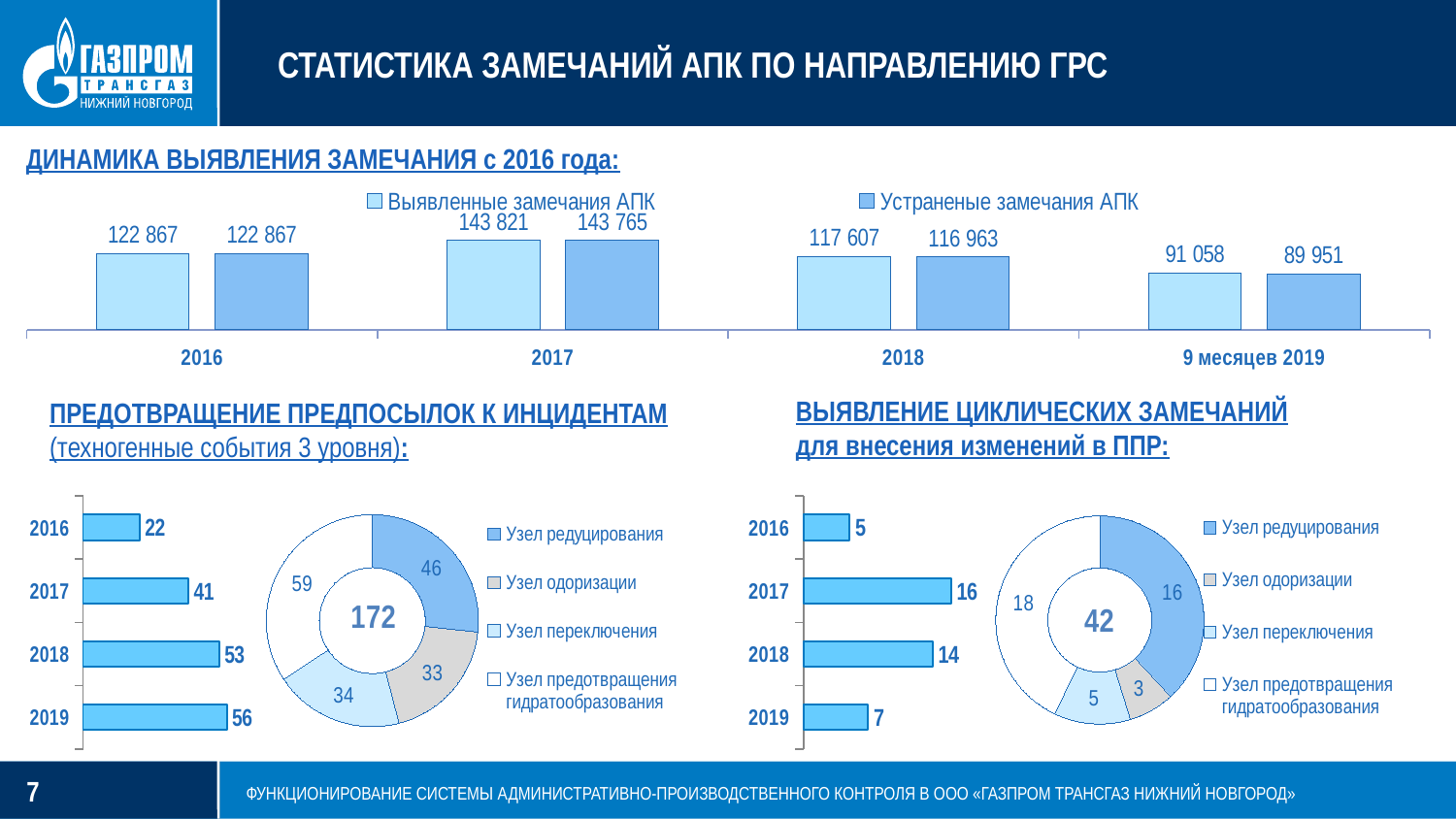
How many series does the legend of the top chart 'ДИНАМИКА ВЫЯВЛЕНИЯ ЗАМЕЧАНИЯ с 2016 года' list? 2 What type of chart is the bottom-right chart showing values by year under 'ВЫЯВЛЕНИЕ ЦИКЛИЧЕСКИХ ЗАМЕЧАНИЙ'? bar chart In the bottom-left bar chart under 'ПРЕДОТВРАЩЕНИЕ ПРЕДПОСЫЛОК К ИНЦИДЕНТАМ', do the values rise or fall from 2016 to 2019? rise In the bottom-left donut chart under 'ПРЕДОТВРАЩЕНИЕ ПРЕДПОСЫЛОК К ИНЦИДЕНТАМ', what total is shown in the centre? 172 In the top chart 'ДИНАМИКА ВЫЯВЛЕНИЯ ЗАМЕЧАНИЯ с 2016 года', what is the value of 'Выявленные замечания АПК' for 2017? 143 821 In the bottom-left donut chart under 'ПРЕДОТВРАЩЕНИЕ ПРЕДПОСЫЛОК К ИНЦИДЕНТАМ', what is the value for 'Узел предотвращения гидратообразования'? 59 In the bottom-right bar chart under 'ВЫЯВЛЕНИЕ ЦИКЛИЧЕСКИХ ЗАМЕЧАНИЙ', which year has the lowest value? 2016 In the top chart 'ДИНАМИКА ВЫЯВЛЕНИЯ ЗАМЕЧАНИЯ с 2016 года', which year has the highest value of 'Выявленные замечания АПК'? 2017 In the top chart 'ДИНАМИКА ВЫЯВЛЕНИЯ ЗАМЕЧАНИЯ с 2016 года', what is the difference between 'Выявленные замечания АПК' and 'Устраненые замечания АПК' in 2018? 644 In the top chart 'ДИНАМИКА ВЫЯВЛЕНИЯ ЗАМЕЧАНИЯ с 2016 года', what is the value of 'Устраненые замечания АПК' for '9 месяцев 2019'? 89 951 In the bottom-right donut chart under 'ВЫЯВЛЕНИЕ ЦИКЛИЧЕСКИХ ЗАМЕЧАНИЙ', which is larger: 'Узел редуцирования' or 'Узел одоризации'? Узел редуцирования In the bottom-left bar chart under 'ПРЕДОТВРАЩЕНИЕ ПРЕДПОСЫЛОК К ИНЦИДЕНТАМ', what is the value for 2018? 53